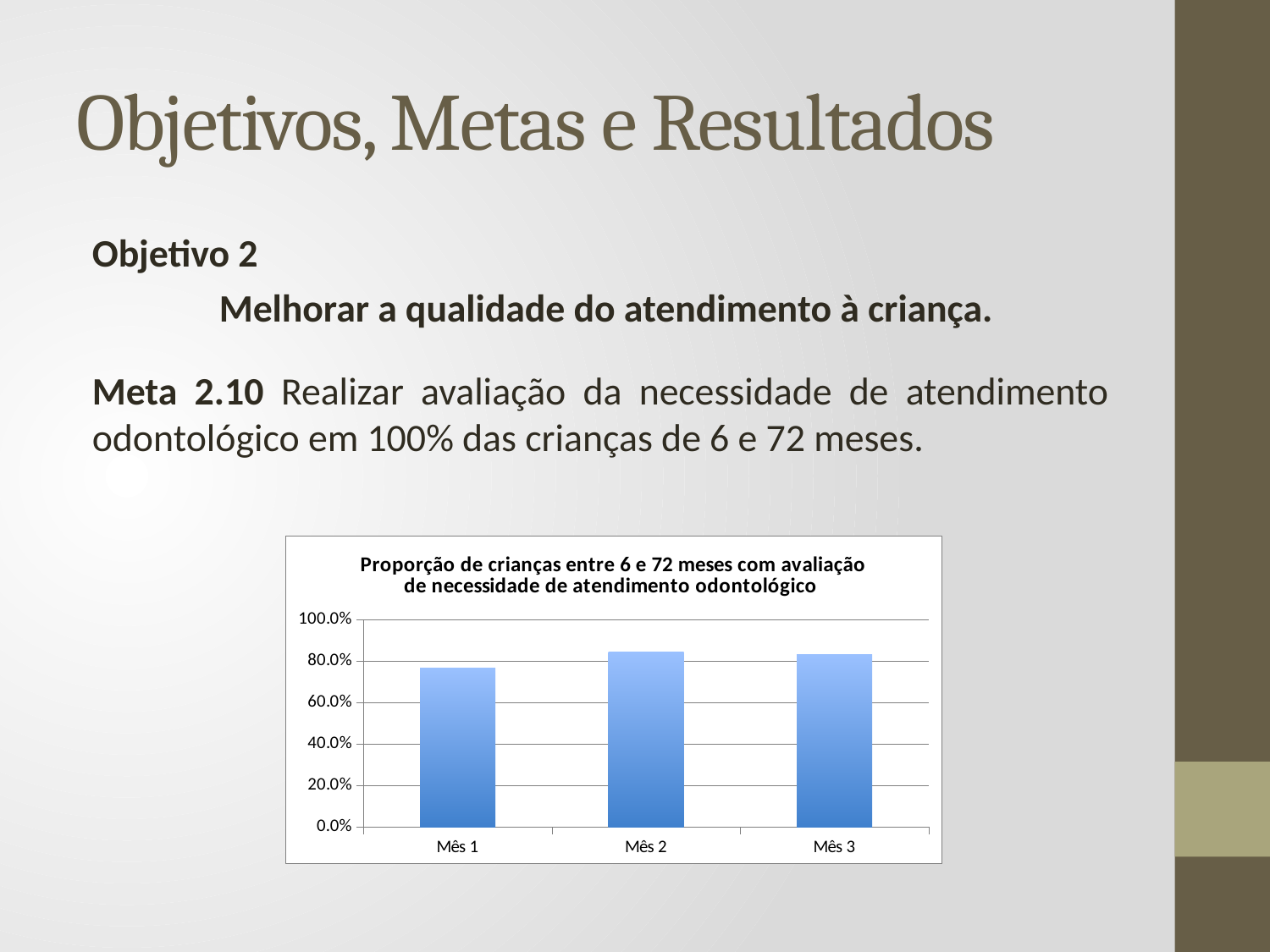
Is the value for Mês 2 greater or less than 100.0%? less Is the value for Mês 3 greater or less than 80.0%? greater Is the value for Mês 1 greater or less than 60.0%? greater What is the title of the chart? Proporção de crianças entre 6 e 72 meses com avaliação de necessidade de atendimento odontológico Which is larger, the value for Mês 3 or the value for Mês 1? Mês 3 Which month has the lowest value in the chart? Mês 1 How many categories (months) are plotted on the x axis of the chart? 3 What is the highest value shown on the y axis of the chart? 100.0% What kind of chart is shown on the slide? bar chart Which is larger, the value for Mês 1 or the value for Mês 2? Mês 2